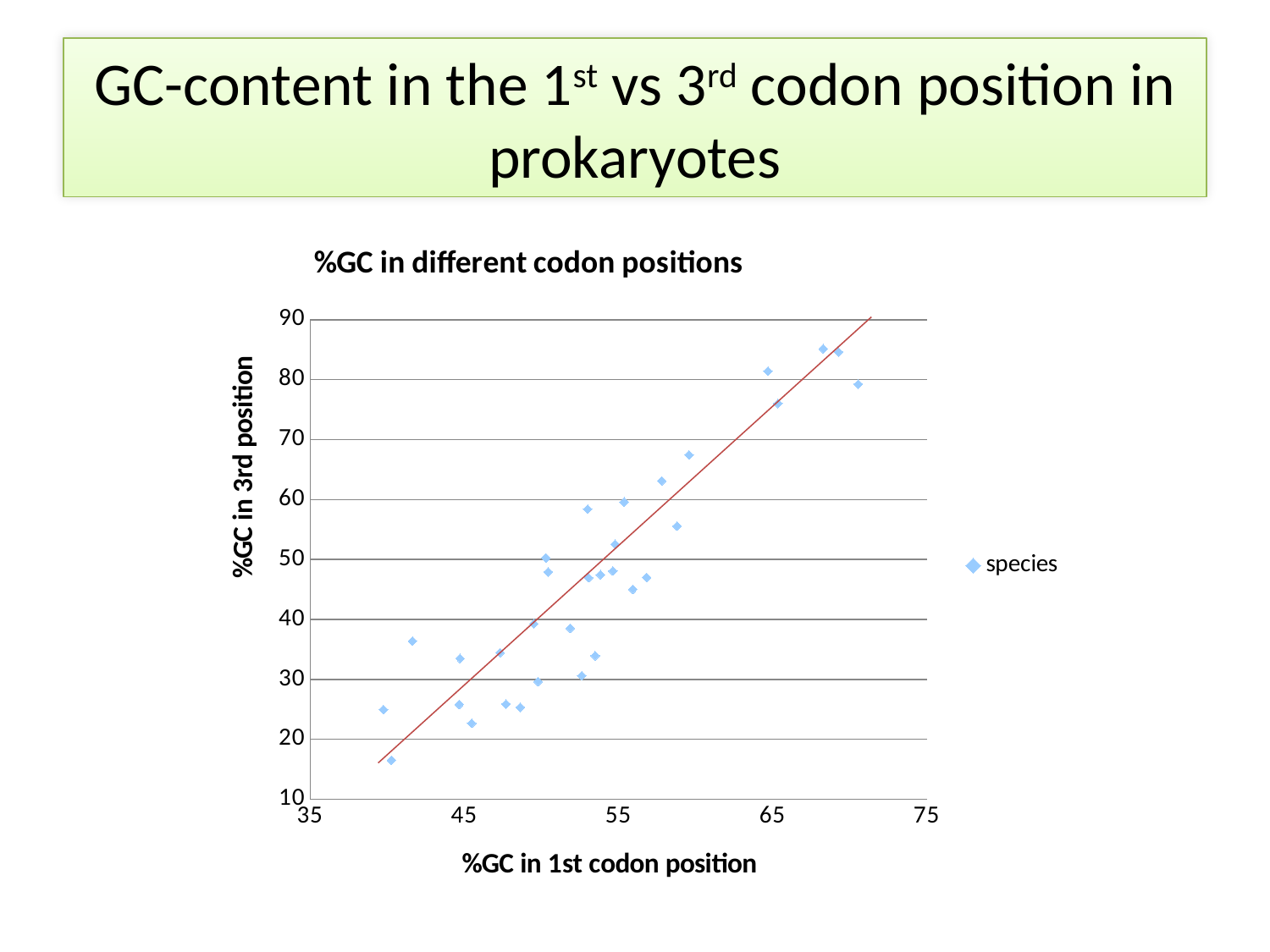
What is the label of the x axis? %GC in 1st codon position Is the %GC in 1st codon position of the lowest point greater or less than 45? less How many series does the legend list? 1 Which is larger: the %GC in 3rd position of the point at about 65 on the x axis, or that of the point at about 40 on the x axis? the point at about 65 Is the %GC in 1st codon position of the highest points greater or less than 65? greater Is the %GC in 3rd position of the rightmost point (near 71 on the x axis) greater or less than 70? greater Do the values of %GC in 3rd position generally rise or fall as %GC in 1st codon position increases? rise What kind of chart is shown on the slide? scatter plot What is the title of the chart? %GC in different codon positions